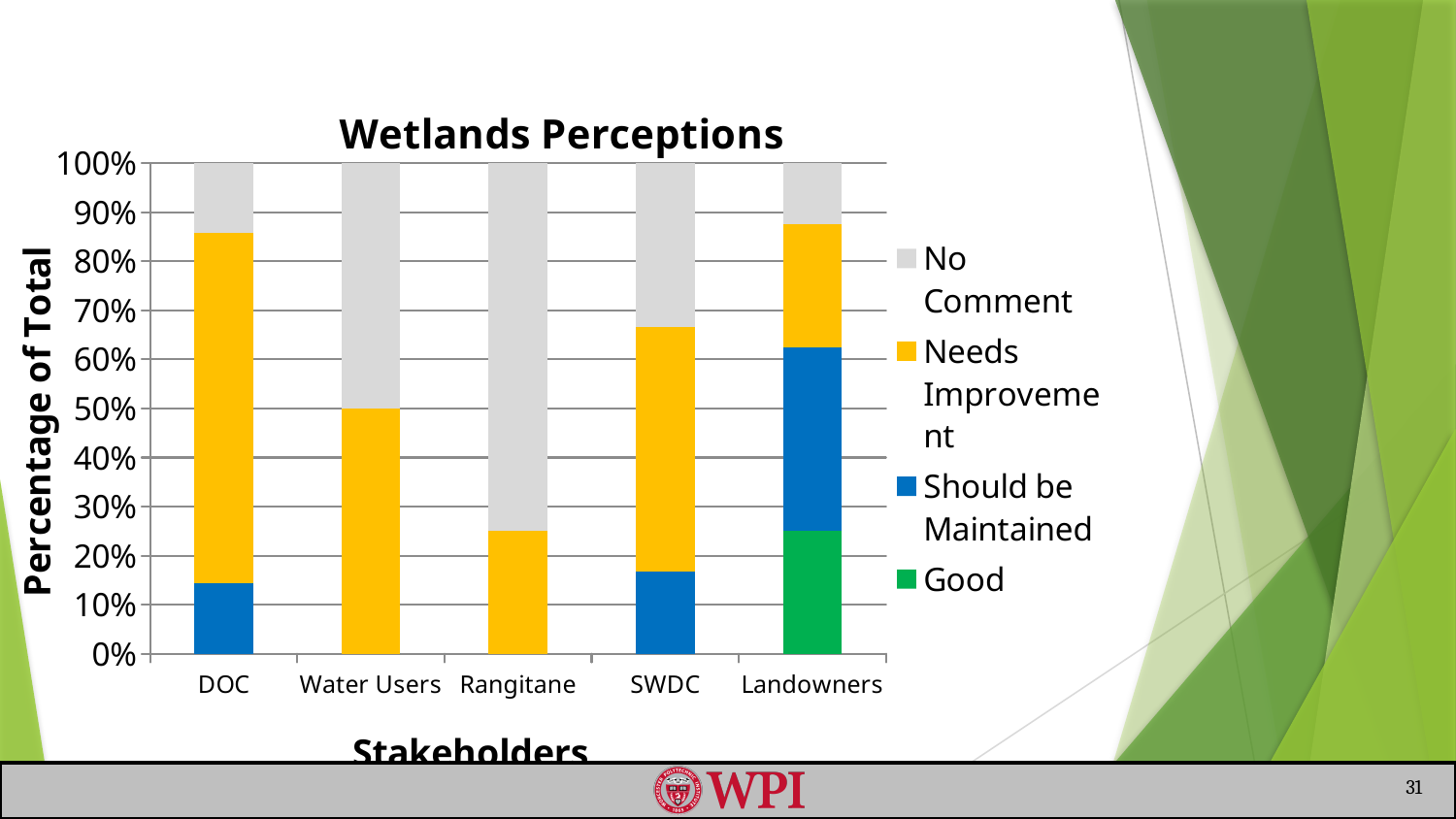
What is the title of the chart? Wetlands Perceptions What type of chart is shown on the slide? Stacked bar chart Is the Needs Improvement share for Rangitane greater or less than 30%? less Is the Good share for Landowners greater or less than 20%? greater Which has the larger Needs Improvement share, DOC or Water Users? DOC What percentage of Water Users responses fall under Needs Improvement? 50% How many stakeholder categories are shown on the x axis? 5 Which stakeholder group is the only one with a Good segment? Landowners What is the label of the vertical axis? Percentage of Total Which stakeholder group has the largest No Comment share? Rangitane Which has the larger No Comment share, Rangitane or SWDC? Rangitane How many series does the legend list? 4